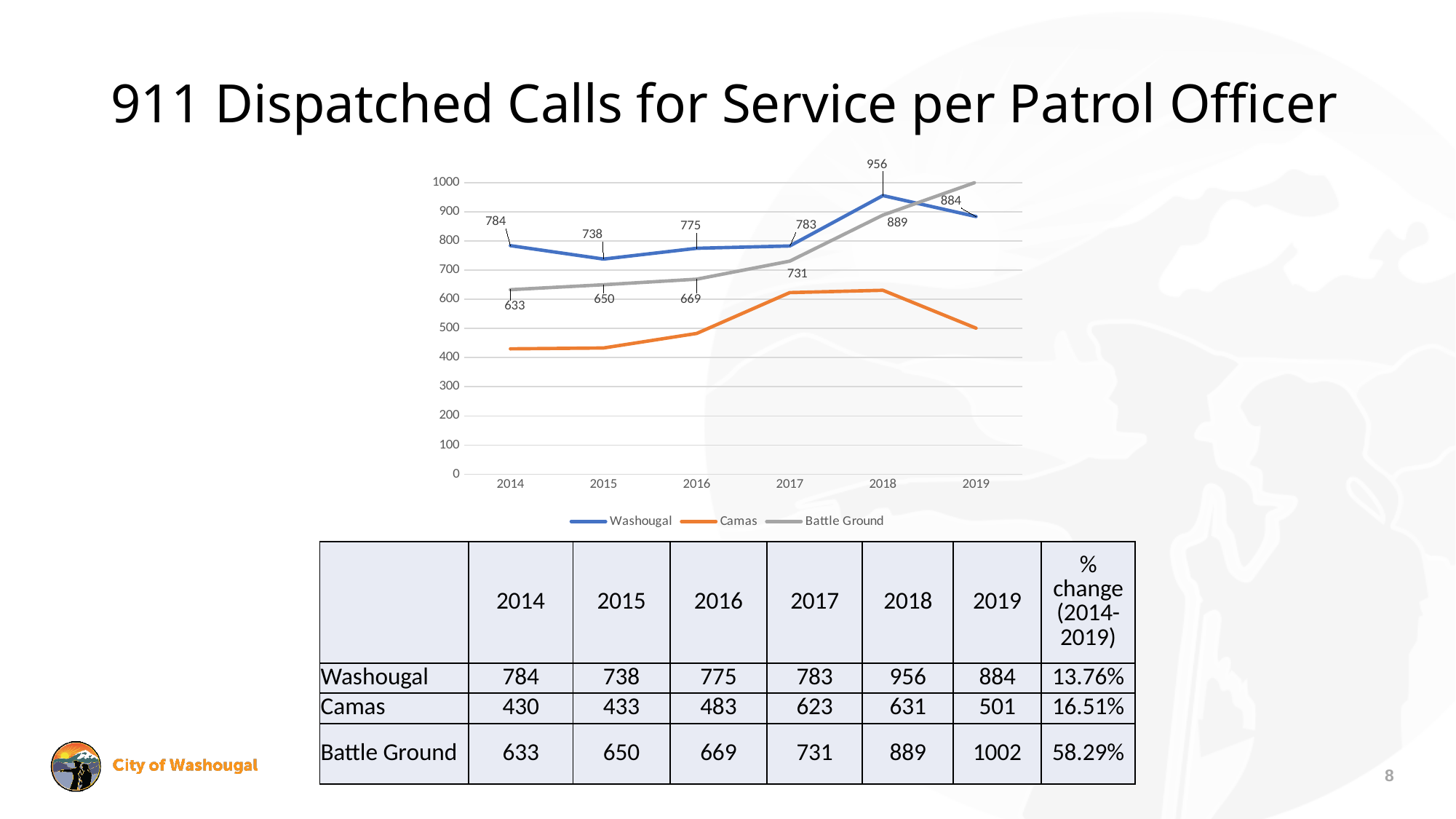
What is the value for Camas in 2017? 623 In which year is the Camas value lowest? 2014 Which is larger in 2019, the value for Washougal or the value for Battle Ground? Battle Ground What is the value for Washougal in 2018? 956 How many series does the chart legend list? 3 What is the value for Battle Ground in 2019? 1002 What kind of chart is shown on the slide? line chart Is the value for Camas in 2019 greater or less than 600? less What is the difference between the Washougal values in 2018 and 2019? 72 In which year is the Washougal value highest? 2018 Does the Battle Ground line rise or fall from 2014 to 2019? rise How many years are plotted along the x axis of the chart? 6